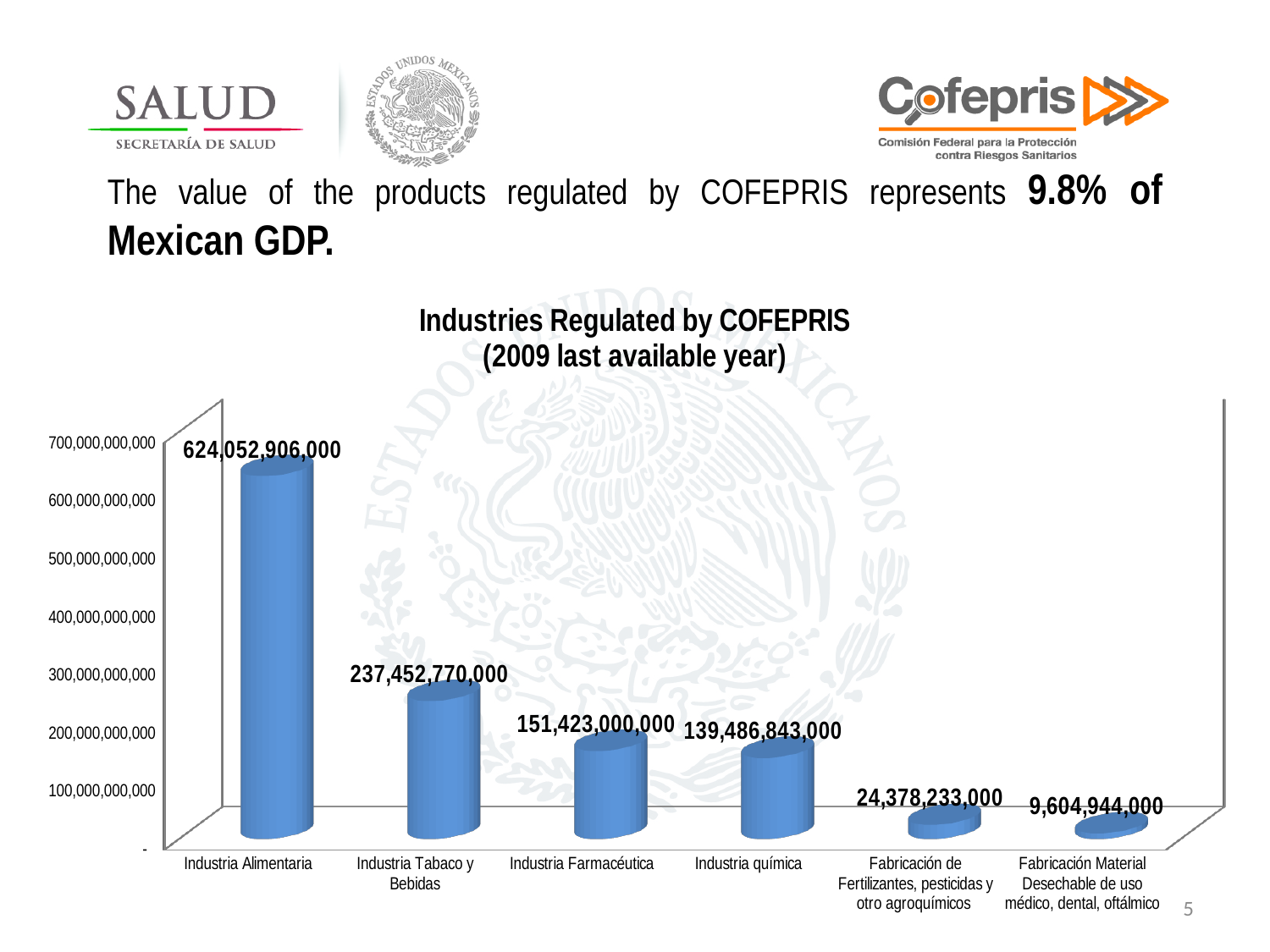
What is the value for Industria Tabaco y Bebidas? 237,452,770,000 What is the difference between the values for Industria Alimentaria and Industria Tabaco y Bebidas? 386,600,136,000 Which is larger, the value for Industria Farmacéutica or Industria química? Industria Farmacéutica What kind of chart is shown on the slide? Bar chart How many industries are shown in the chart? 6 Do the values rise or fall from left to right across the categories? Fall What is the value for Industria Alimentaria? 624,052,906,000 What is the value for Fabricación Material Desechable de uso médico, dental, oftálmico? 9,604,944,000 What is the value for Industria química? 139,486,843,000 Which industry has the lowest value? Fabricación Material Desechable de uso médico, dental, oftálmico What is the value for Industria Farmacéutica? 151,423,000,000 Which industry has the highest value? Industria Alimentaria